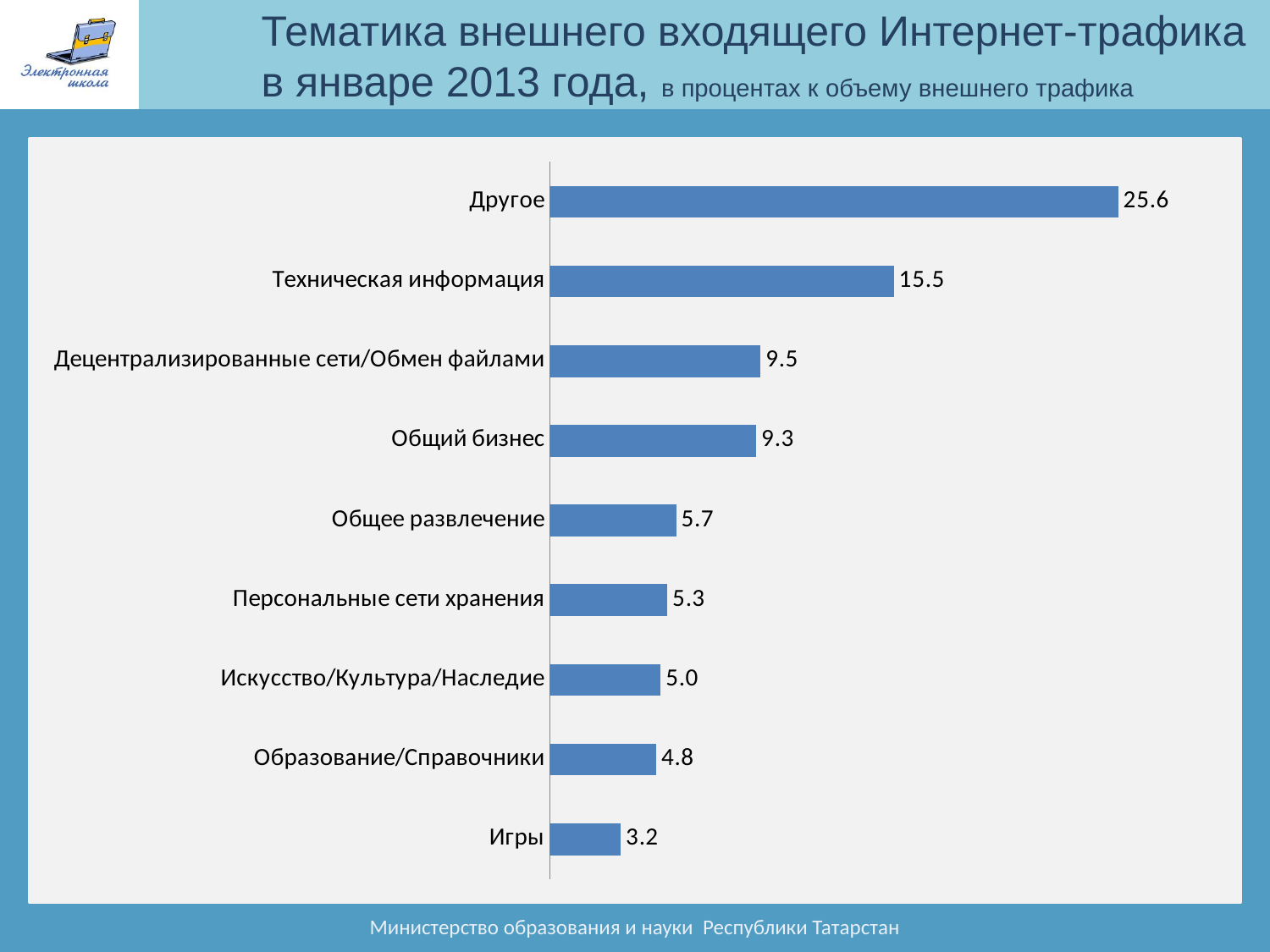
What is the difference between the values for Общий бизнес and Игры? 6.1 What is the value for Игры? 3.2 What is the value for Образование/Справочники? 4.8 Which category has the lowest value? Игры Which category has the highest value? Другое How many categories are shown in the chart? 9 What is the value for Техническая информация? 15.5 Which is larger, the value for Децентрализированные сети/Обмен файлами or the value for Общее развлечение? Децентрализированные сети/Обмен файлами What is the value for Общее развлечение? 5.7 What kind of chart is shown on the slide? Bar chart Which is larger, the value for Персональные сети хранения or the value for Искусство/Культура/Наследие? Персональные сети хранения What is the difference between the values for Другое and Техническая информация? 10.1